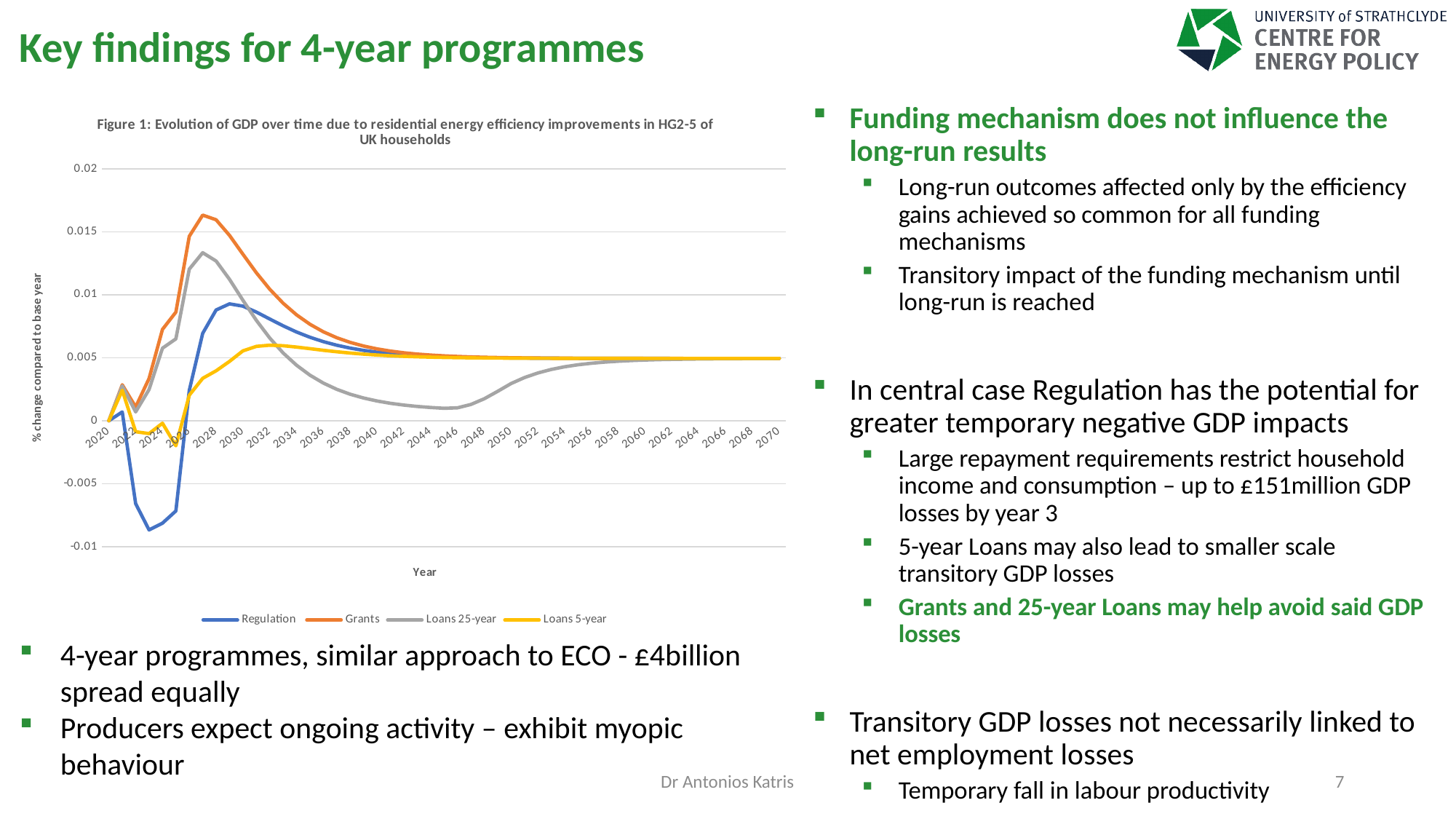
What is the label of the vertical axis in Figure 1? % change compared to base year Which series in Figure 1 has the lowest value around 2046? Loans 25-year In Figure 1, is the peak value of the Loans 5-year series greater or less than 0.01? less In Figure 1, around 2028, which series is higher: Grants or Loans 5-year? Grants In Figure 1, does the Loans 25-year series rise or fall between 2028 and 2046? fall Which series in Figure 1 falls to the lowest value? Regulation In Figure 1, is the peak value of the Grants series greater or less than 0.015? greater Which series in Figure 1 reaches the highest peak value? Grants What kind of chart is shown in Figure 1? line chart What are the series names listed in the legend of Figure 1? Regulation, Grants, Loans 25-year, Loans 5-year In Figure 1, is the lowest value of the Regulation series greater or less than -0.005? less How many series does the legend of Figure 1 list? 4